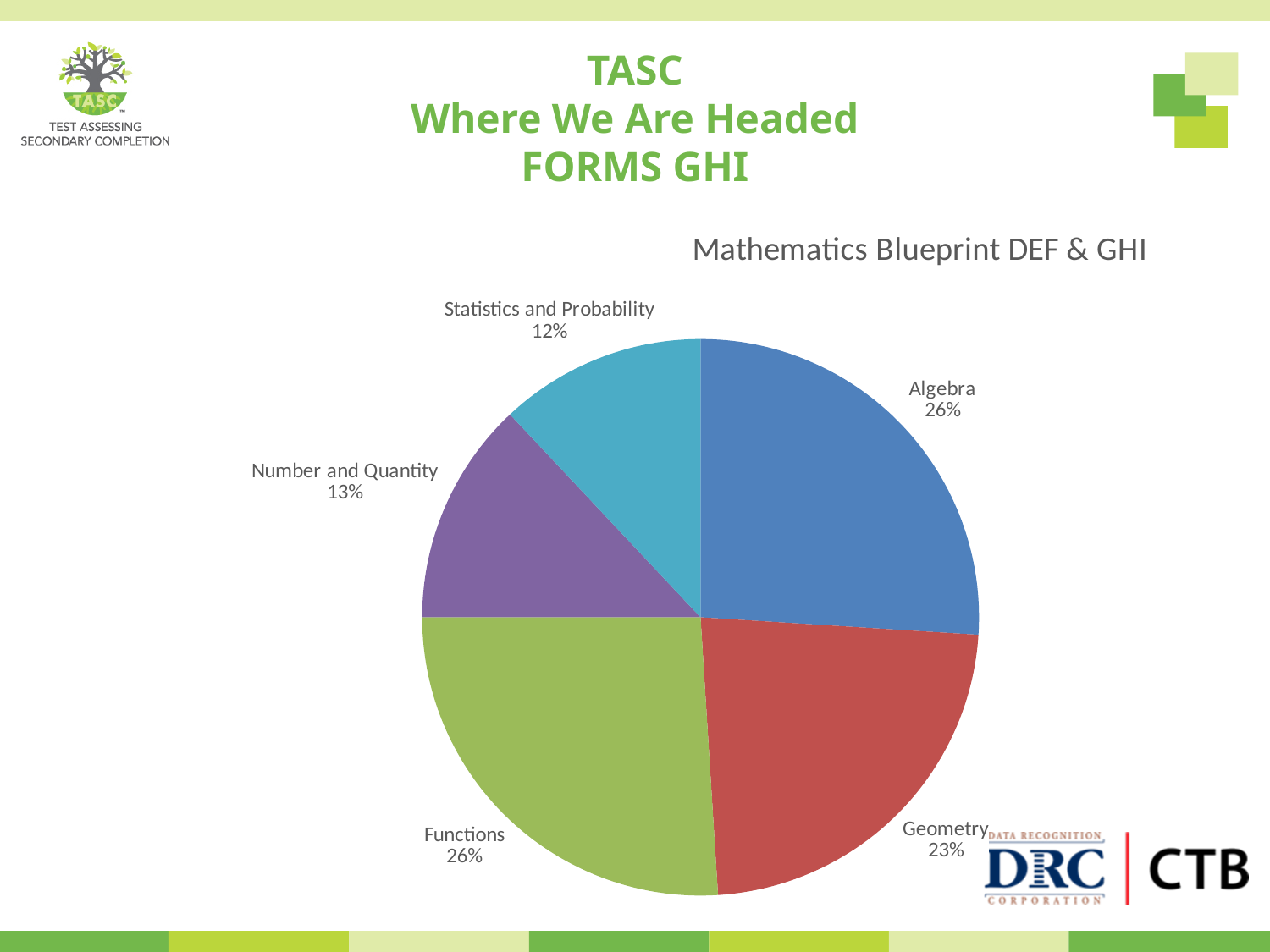
Which is larger, the share for Geometry or the share for Number and Quantity? Geometry What percentage of the pie does Functions represent? 26% What percentage of the pie does Number and Quantity represent? 13% What is the difference in percentage points between Functions and Statistics and Probability? 14 What percentage of the pie does Statistics and Probability represent? 12% What percentage of the pie does Algebra represent? 26% What is the difference in percentage points between Algebra and Geometry? 3 How many slices does the pie chart have? 5 What type of chart is shown on the slide? Pie chart Which category has the smallest share of the pie? Statistics and Probability What is the title of the chart? Mathematics Blueprint DEF & GHI What percentage of the pie does Geometry represent? 23%